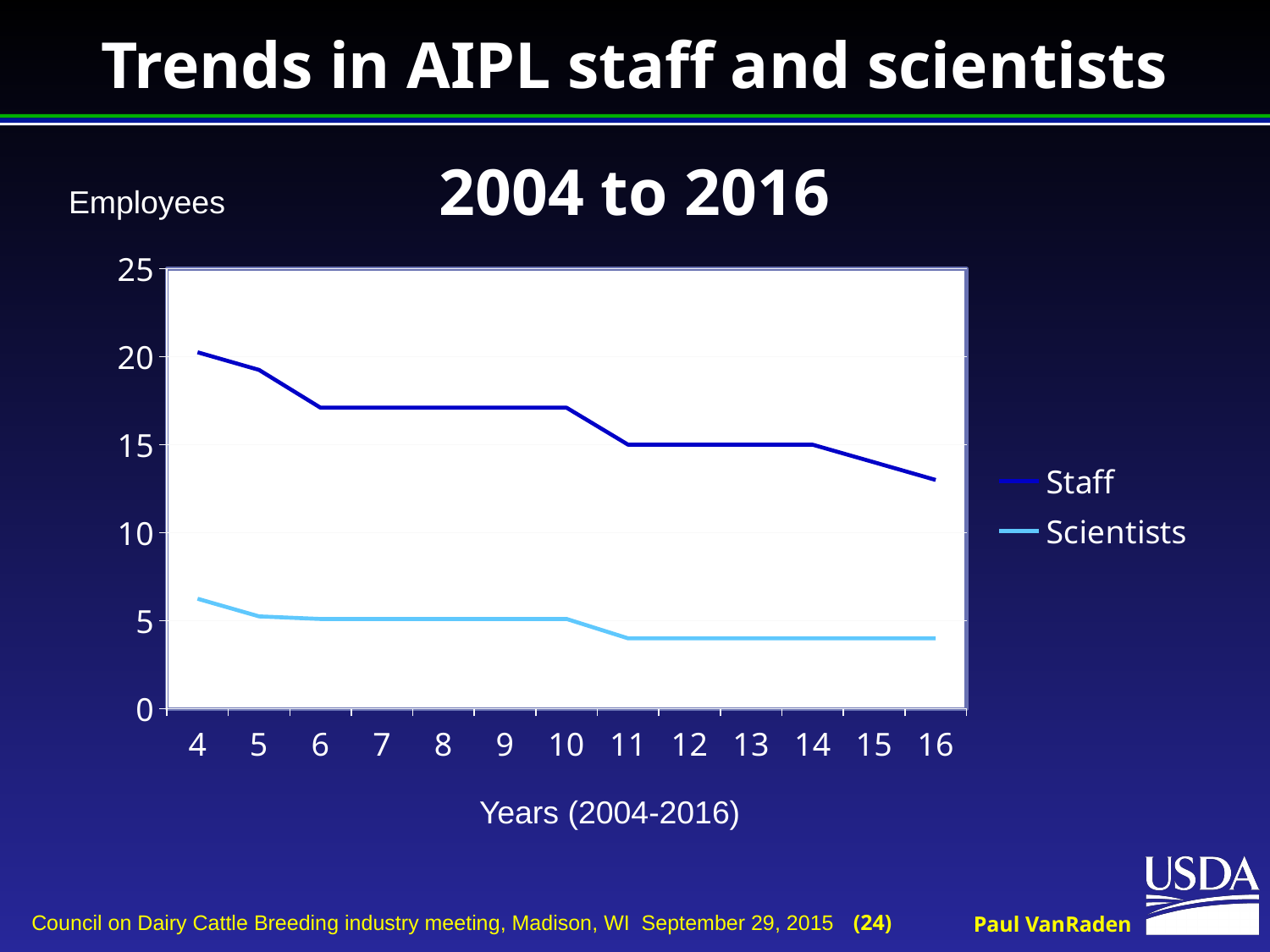
Which series has the larger value in year 10, Staff or Scientists? Staff What kind of chart is shown on the slide? line chart How many series does the legend list? 2 What is the label on the x axis of the chart? Years (2004-2016) How many years are plotted along the x axis? 13 In which year is the Staff value highest? 4 In which year is the Staff value lowest? 16 Is the Staff value for year 16 greater or less than 15? less Is the Staff value for year 4 greater or less than 15? greater Does the Scientists line rise or fall from year 4 to year 16? fall Does the Staff line rise or fall from year 4 to year 16? fall Is the Scientists value for year 16 greater or less than 5? less